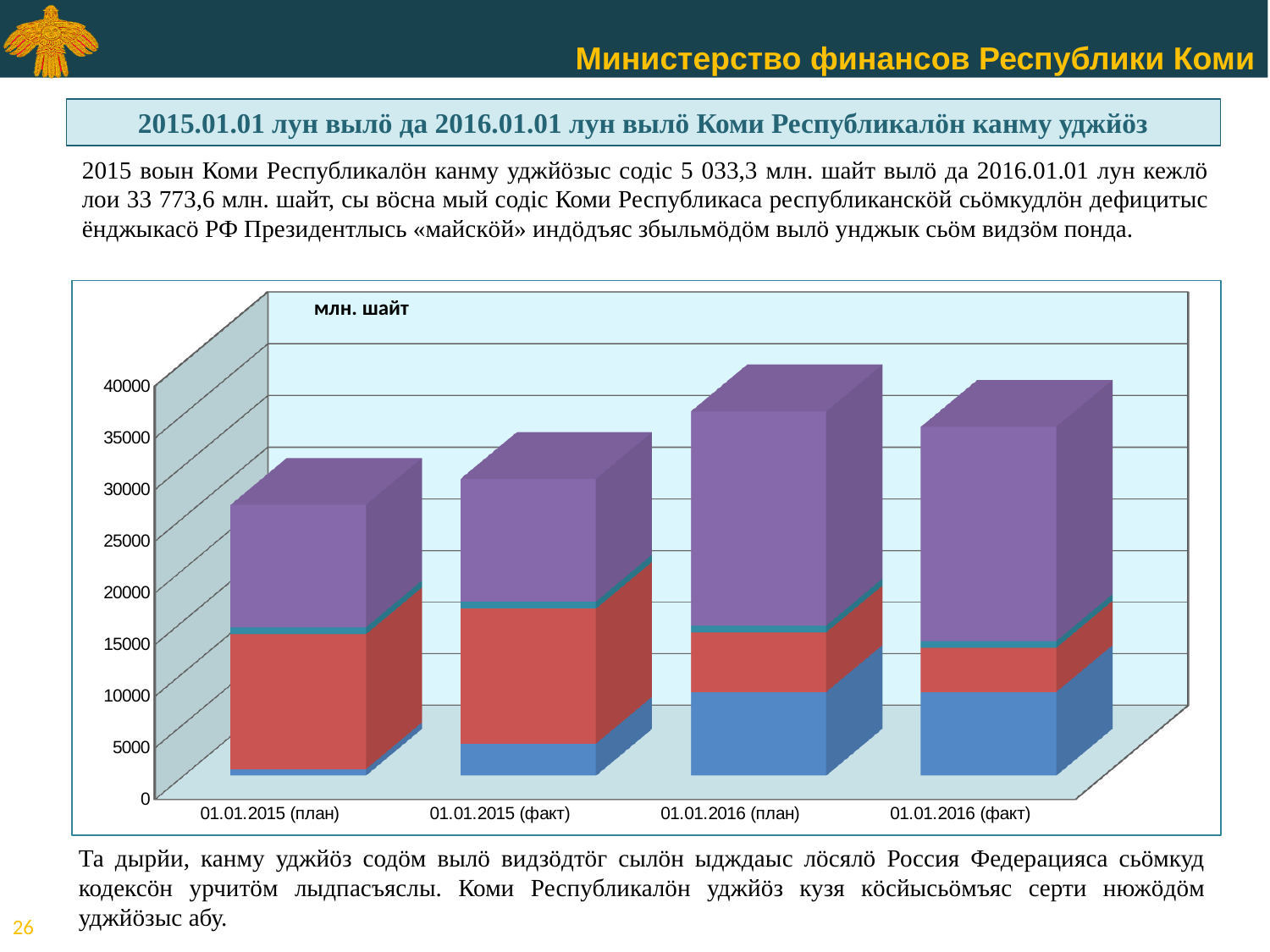
What kind of chart is shown on the slide? stacked bar chart Which category has the shortest stacked bar? 01.01.2015 (план) What unit label is shown at the top of the chart's value axis? млн. шайт Which category has the tallest stacked bar? 01.01.2016 (план) Which stacked bar is taller: 01.01.2015 (план) or 01.01.2015 (факт)? 01.01.2015 (факт) Is the total of the stacked bar for 01.01.2015 (план) greater or less than 30000? less Is the total of the stacked bar for 01.01.2015 (план) greater or less than 25000? greater Do the stacked bar totals rise or fall from 01.01.2015 (план) to 01.01.2016 (план)? rise Which stacked bar is taller: 01.01.2016 (план) or 01.01.2016 (факт)? 01.01.2016 (план) How many categories are shown on the x axis of the chart? 4 Is the bottom (blue) segment of the 01.01.2015 (план) bar greater or less than 5000? less